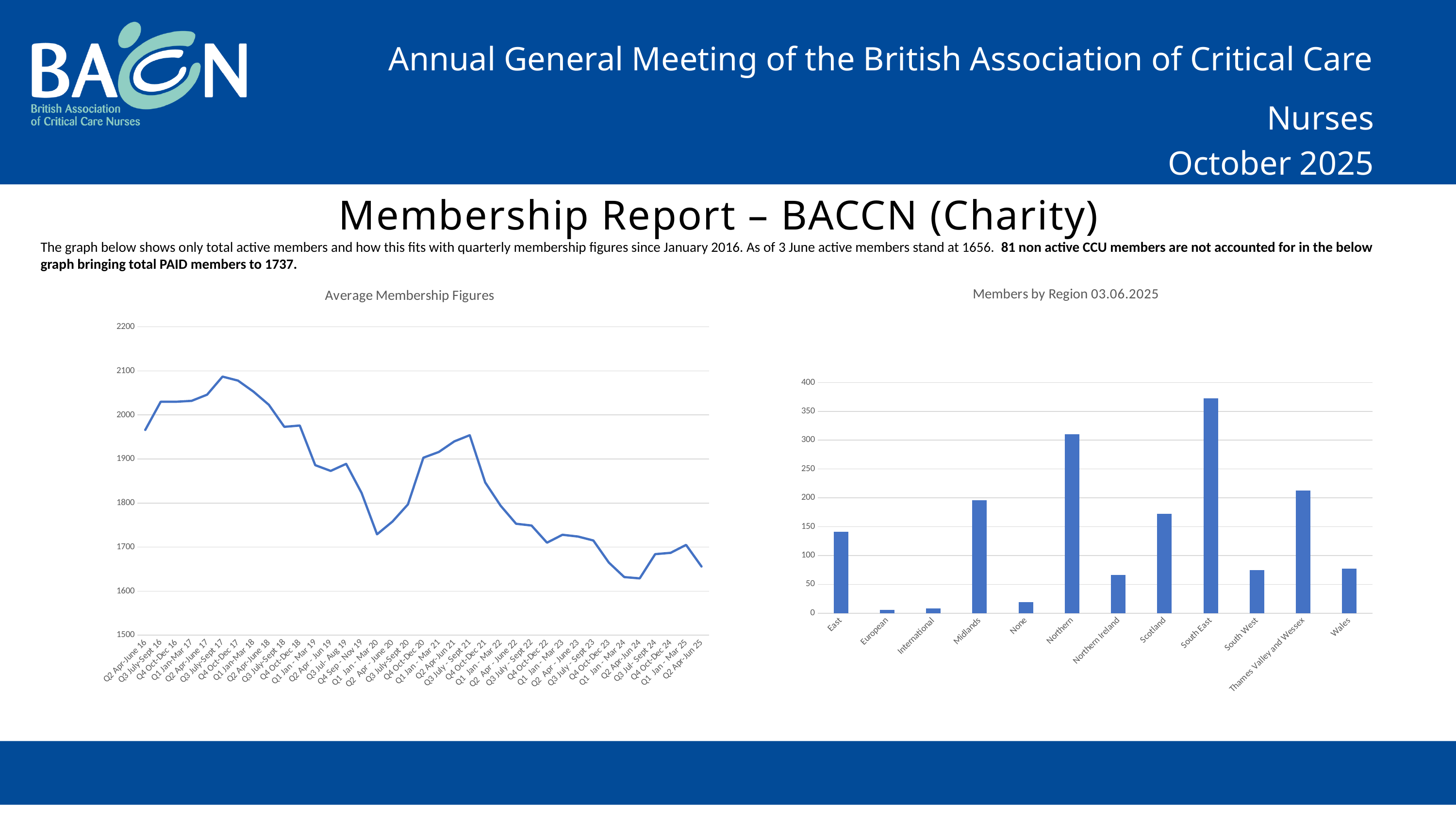
In the 'Average Membership Figures' chart, do the values overall rise or fall from the first quarter to the last quarter shown? fall In the 'Members by Region 03.06.2025' chart, is the value for Wales greater or less than 50? greater In the 'Average Membership Figures' chart, is the value for Q1 Jan-Mar 20 greater or less than 1800? less What kind of chart is the 'Members by Region 03.06.2025' chart? bar chart In the 'Members by Region 03.06.2025' chart, is the value for South East greater or less than 350? greater In the 'Members by Region 03.06.2025' chart, which region has the lowest number of members? European In the 'Members by Region 03.06.2025' chart, which region has the highest number of members? South East In the 'Members by Region 03.06.2025' chart, which has more members, Northern or Midlands? Northern What kind of chart is the 'Average Membership Figures' chart? line chart In the 'Members by Region 03.06.2025' chart, how many regions are shown on the x axis? 12